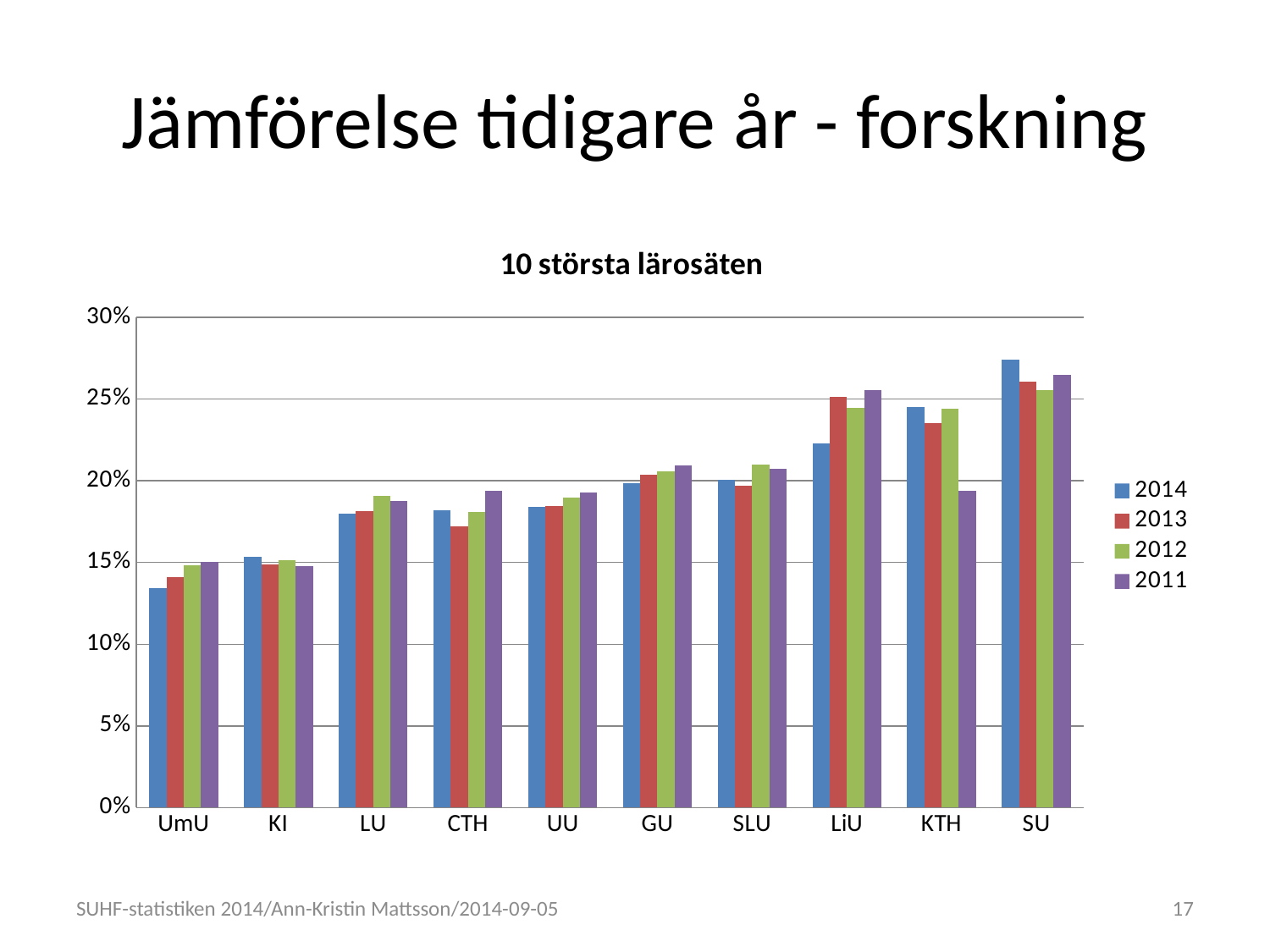
Is the 2014 value for UmU greater or less than 15%? less For UmU, which is larger: the 2014 value or the 2011 value? 2011 How many institutions (categories) are shown on the x axis? 10 Do the 2014 values generally rise or fall from UmU on the left to SU on the right? rise Which is larger for 2014: the value for LiU or the value for KTH? KTH Is the 2014 value for SU greater or less than 25%? greater Which institution has the lowest value for 2014? UmU How many series does the legend list? 4 Which institution has the highest value for 2014? SU Is the 2011 value for KTH greater or less than 20%? less What is the title of the chart? 10 största lärosäten What kind of chart is shown on the slide? bar chart